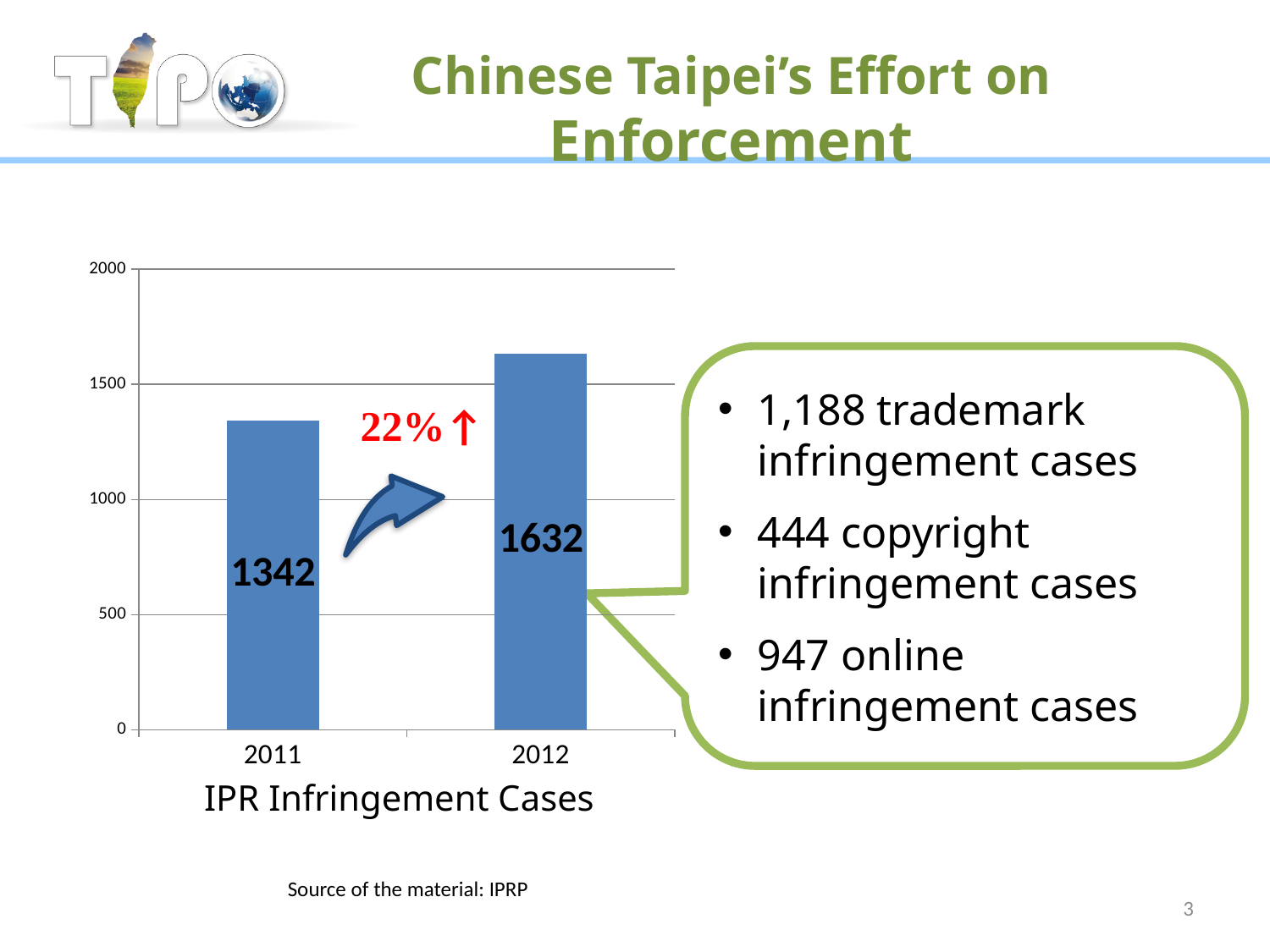
What is the value for 2011 in the IPR Infringement Cases chart? 1342 Which year has the higher number of IPR infringement cases? 2012 What kind of chart is shown on the slide? bar chart Is the value for 2011 greater or less than 1500? less Which year has the lower number of IPR infringement cases? 2011 Is the value for 2012 greater or less than 1500? greater What is the title shown below the chart? IPR Infringement Cases What percentage change is annotated between the two bars? 22%↑ What is the difference between the 2012 and 2011 values in the IPR Infringement Cases chart? 290 How many years are shown on the x axis of the chart? 2 Do the values rise or fall from 2011 to 2012? rise What is the value for 2012 in the IPR Infringement Cases chart? 1632